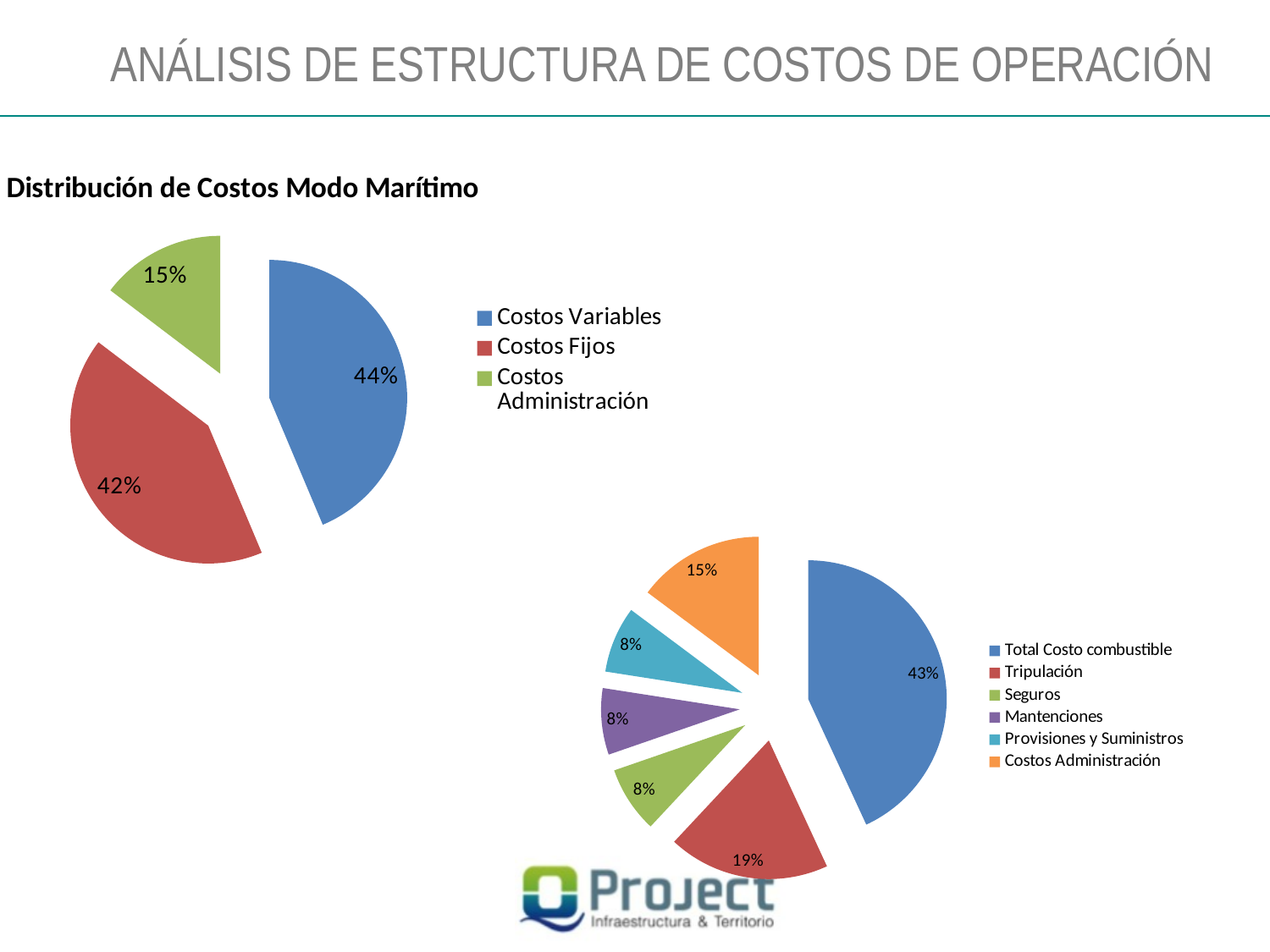
What kind of chart is the lower-right chart? Pie chart In the lower-right pie chart, what colour is the Costos Administración slice? Orange In the upper-left pie chart, what share is labelled for Costos Variables? 44% In the lower-right pie chart, what share is labelled for Total Costo combustible? 43% How many slices does the upper-left pie chart have? 3 In the upper-left pie chart, which category has the smallest slice? Costos Administración In the upper-left pie chart, what share is labelled for Costos Fijos? 42% In the upper-left pie chart, what is the difference between the Costos Variables share and the Costos Administración share? 29% In the lower-right pie chart, which category has the largest slice? Total Costo combustible How many entries does the legend of the lower-right pie chart list? 6 In the lower-right pie chart, which is larger, Tripulación or Costos Administración? Tripulación